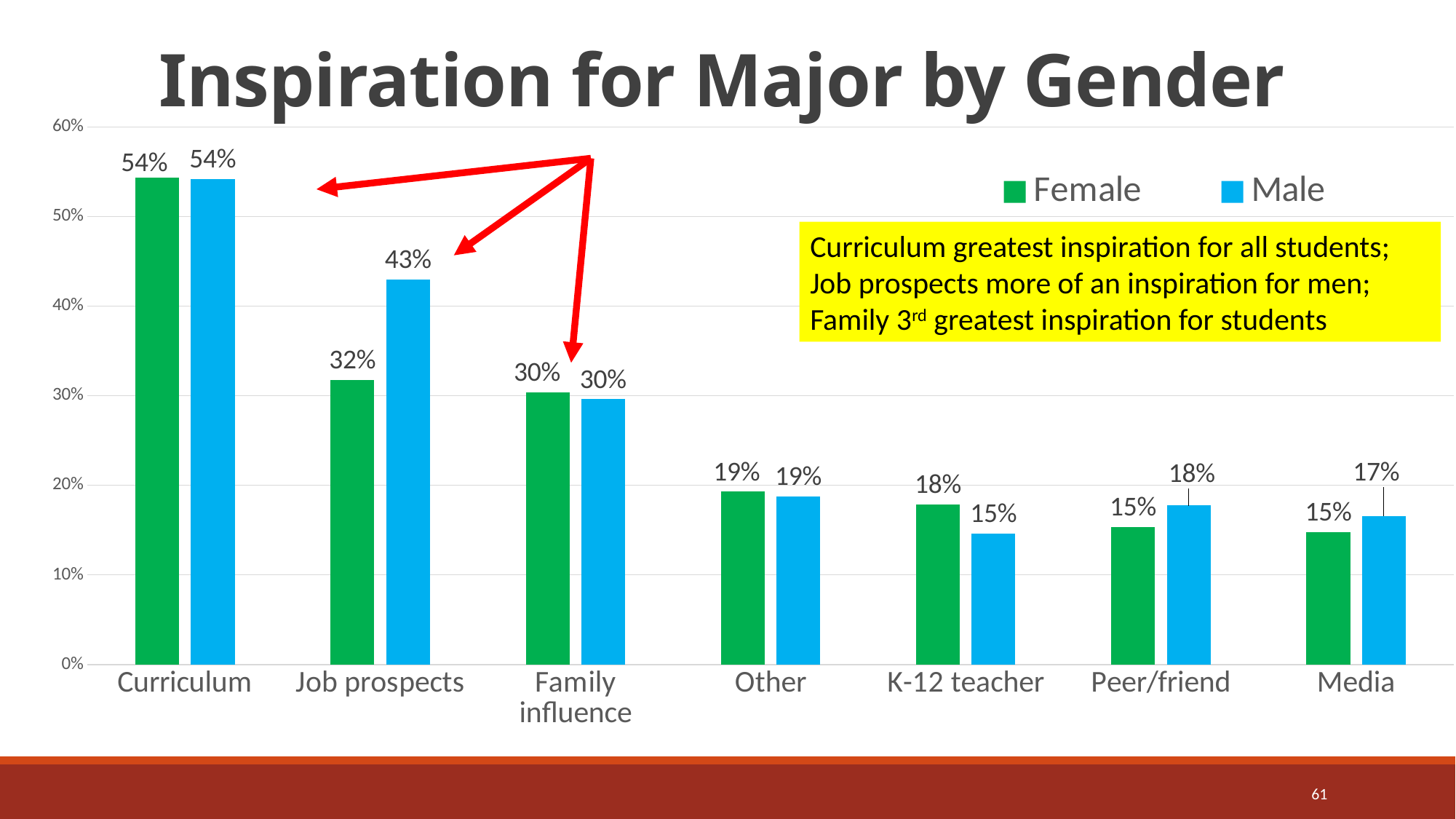
What is the Female value for Media? 15% How many series does the legend list? 2 What is the Female value for Job prospects? 32% What is the difference between the Male and Female values for Job prospects? 11% What is the Male value for Job prospects? 43% Which is larger for Peer/friend, the Female value or the Male value? Male What kind of chart is shown on the slide? Bar chart Which category has the highest Female value? Curriculum How many categories are shown on the x axis? 7 Which category has the lowest Male value? K-12 teacher What is the Male value for K-12 teacher? 15% Is the Male value for Curriculum greater or less than 50%? greater